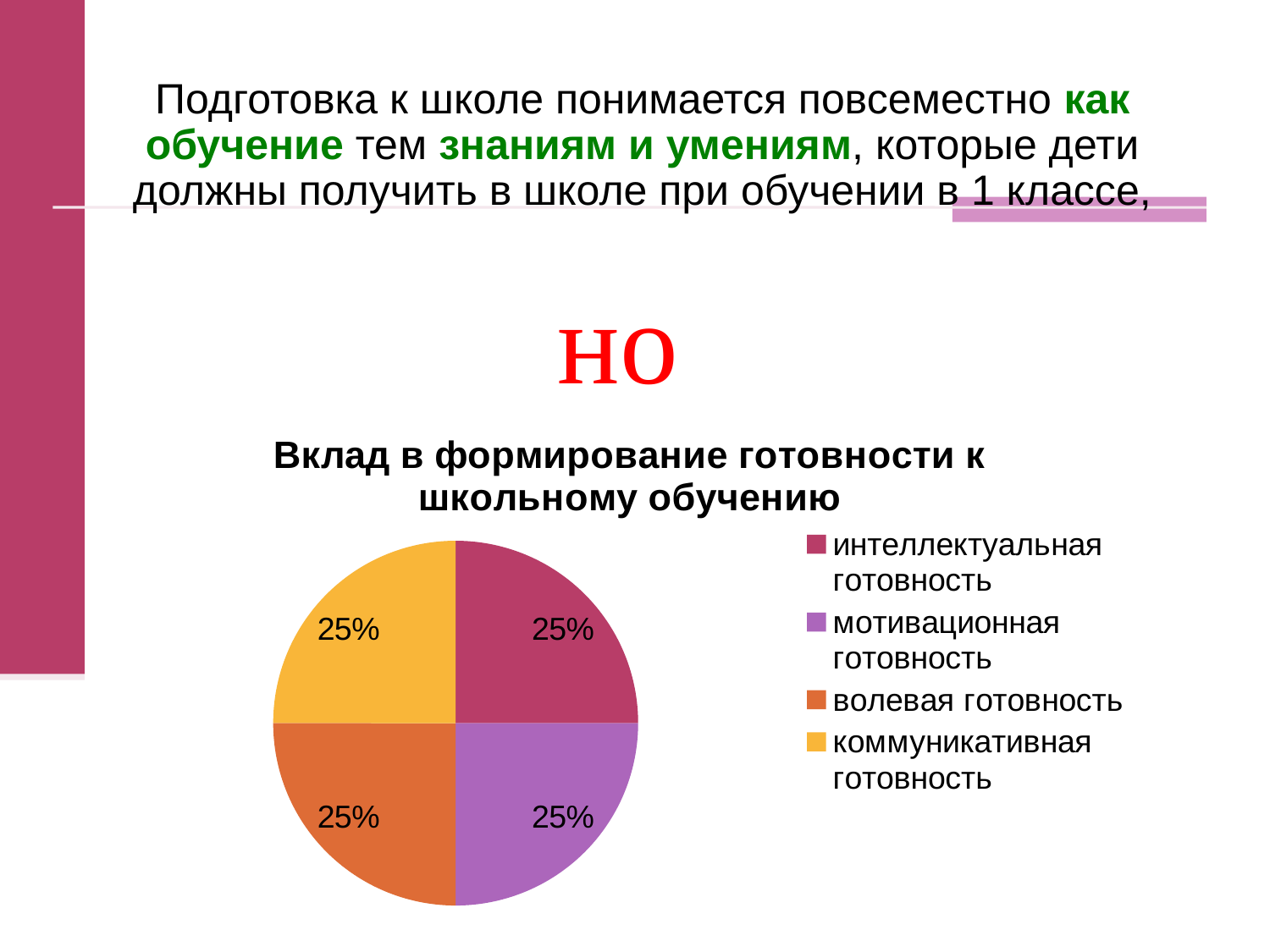
What share of the pie does интеллектуальная готовность take? 25% What is the total of all the slice values shown on the pie chart? 100% What is the difference between the values for интеллектуальная готовность and волевая готовность? 0% What is the title of the chart? Вклад в формирование готовности к школьному обучению How many slices does the pie chart have? 4 What is the value shown for мотивационная готовность? 25% What kind of chart is shown on the slide? pie chart Which legend entry is shown in yellow? коммуникативная готовность What is the value shown for волевая готовность? 25% What share of the pie does коммуникативная готовность take? 25% How many entries does the legend list? 4